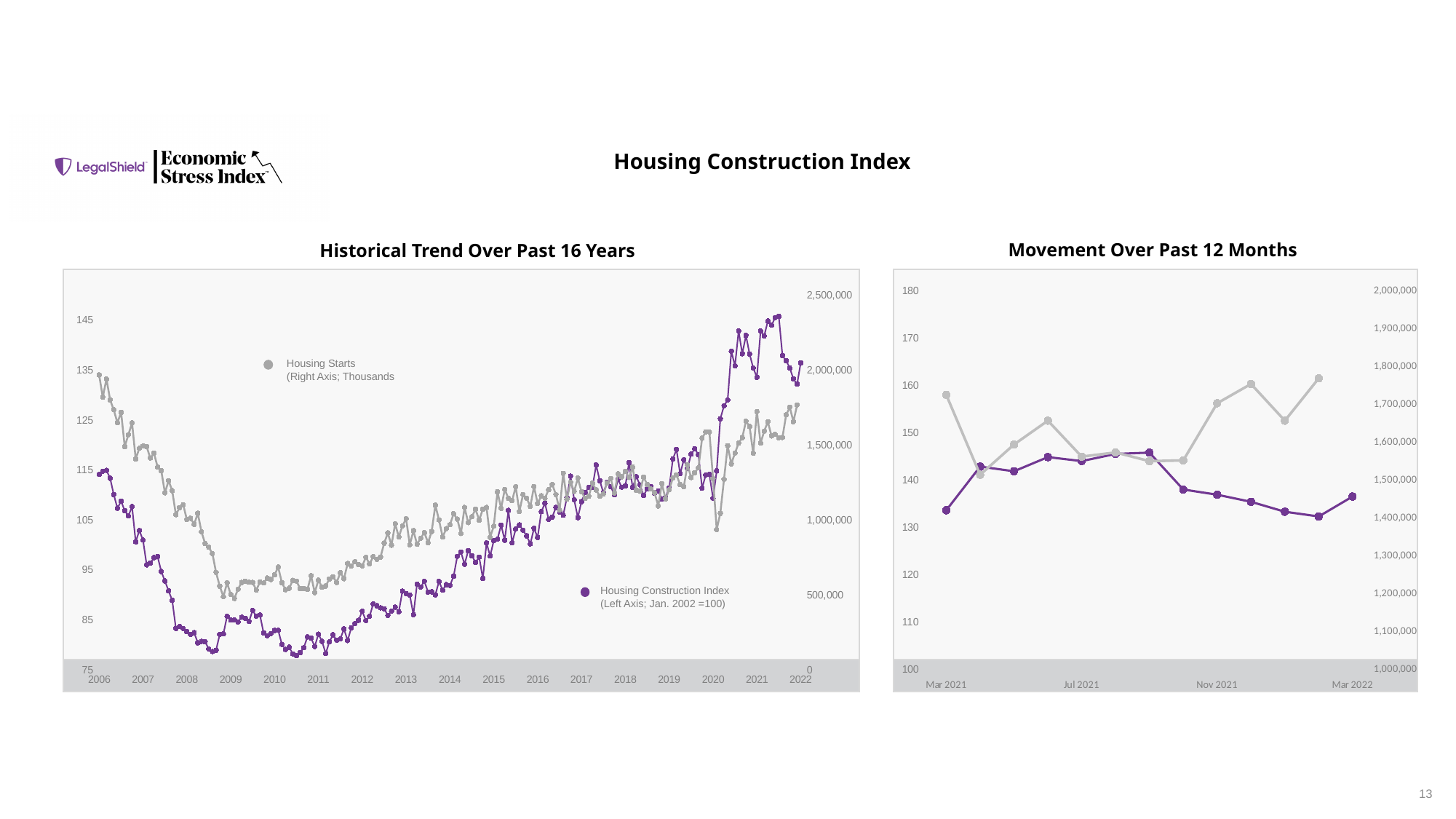
What kind of chart is the 'Historical Trend Over Past 16 Years' chart? line chart In the 'Movement Over Past 12 Months' chart, is the Housing Construction Index for Mar 2021 greater or less than 140? less In the 'Historical Trend Over Past 16 Years' chart, is the lowest point of the Housing Construction Index around 2010 greater or less than 85? less In the 'Historical Trend Over Past 16 Years' chart, is the Housing Construction Index at the start of 2006 greater or less than 105? greater In the 'Historical Trend Over Past 16 Years' chart, what colour is the Housing Construction Index line? purple In the 'Historical Trend Over Past 16 Years' chart, does the Housing Construction Index rise or fall between 2011 and 2021? rise In the 'Historical Trend Over Past 16 Years' chart, which series is plotted on the right axis? Housing Starts In the 'Historical Trend Over Past 16 Years' chart, does the Housing Construction Index rise or fall between 2006 and 2010? fall What kind of chart is the 'Movement Over Past 12 Months' chart? line chart In the 'Movement Over Past 12 Months' chart, is the Housing Construction Index higher in Mar 2021 or in Sep 2021? Sep 2021 How many series does the legend of the 'Historical Trend Over Past 16 Years' chart list? 2